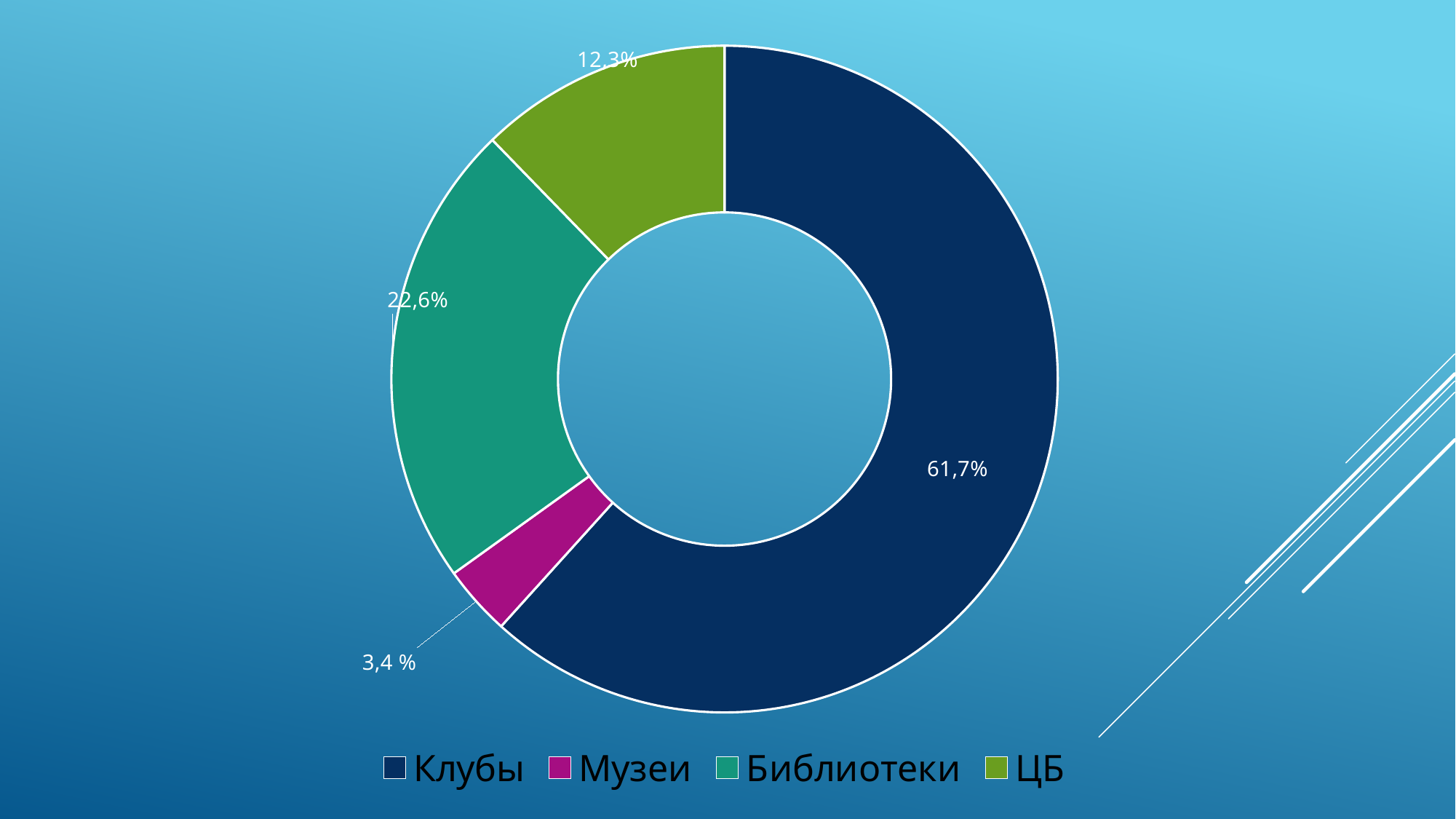
What percentage does the Музеи slice show? 3,4 % What percentage does the Библиотеки slice show? 22,6% What is the difference in percentage points between Библиотеки and ЦБ? 10,3 Which category has the largest share of the chart? Клубы What percentage does the ЦБ slice show? 12,3% What kind of chart is shown on the slide? doughnut chart Which category has the smallest share of the chart? Музеи What colour is the Музеи slice? magenta What is the difference in percentage points between Клубы and Библиотеки? 39,1 What percentage does the Клубы slice show? 61,7% How many categories does the chart show? 4 Which is larger, the share for Библиотеки or the share for ЦБ? Библиотеки